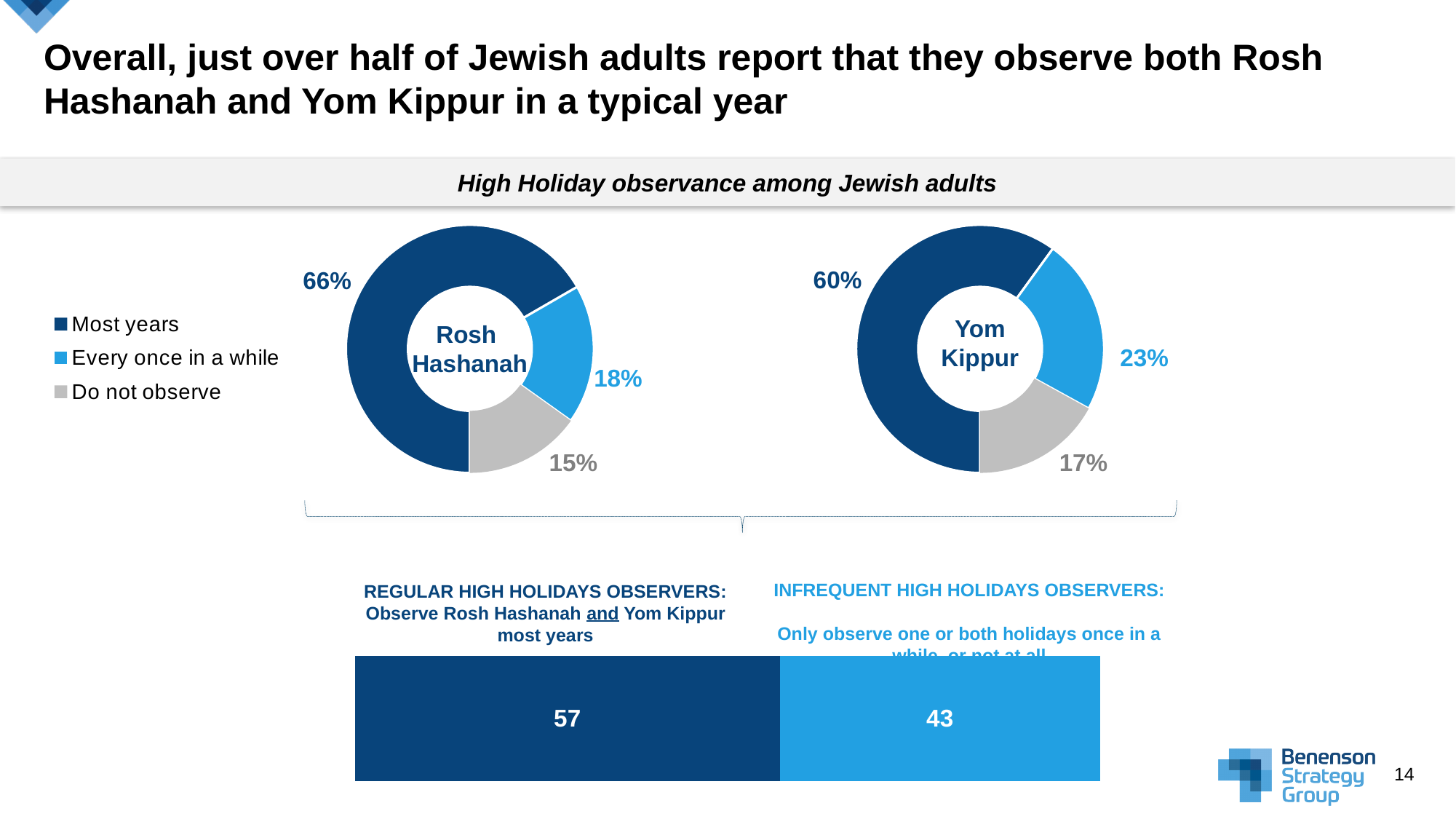
In the Yom Kippur chart, what percentage of Jewish adults observe it every once in a while? 23% In the bottom bar chart, what is the value for regular High Holidays observers? 57 Is the 'Every once in a while' share larger for Rosh Hashanah or for Yom Kippur? Yom Kippur In the Rosh Hashanah chart, which category has the smallest share? Do not observe How many categories does the legend list for the donut charts? 3 What kind of chart is used to show Rosh Hashanah observance? Donut (pie) chart What is the difference between the 'Most years' share for Rosh Hashanah and for Yom Kippur? 6 percentage points In the bottom bar chart, what is the total of the two segments? 100 In the Yom Kippur chart, what percentage of Jewish adults do not observe it? 17% In the Yom Kippur chart, which category has the largest share? Most years What is the title of the chart section on the slide? High Holiday observance among Jewish adults In the Rosh Hashanah chart, what percentage of Jewish adults observe it most years? 66%